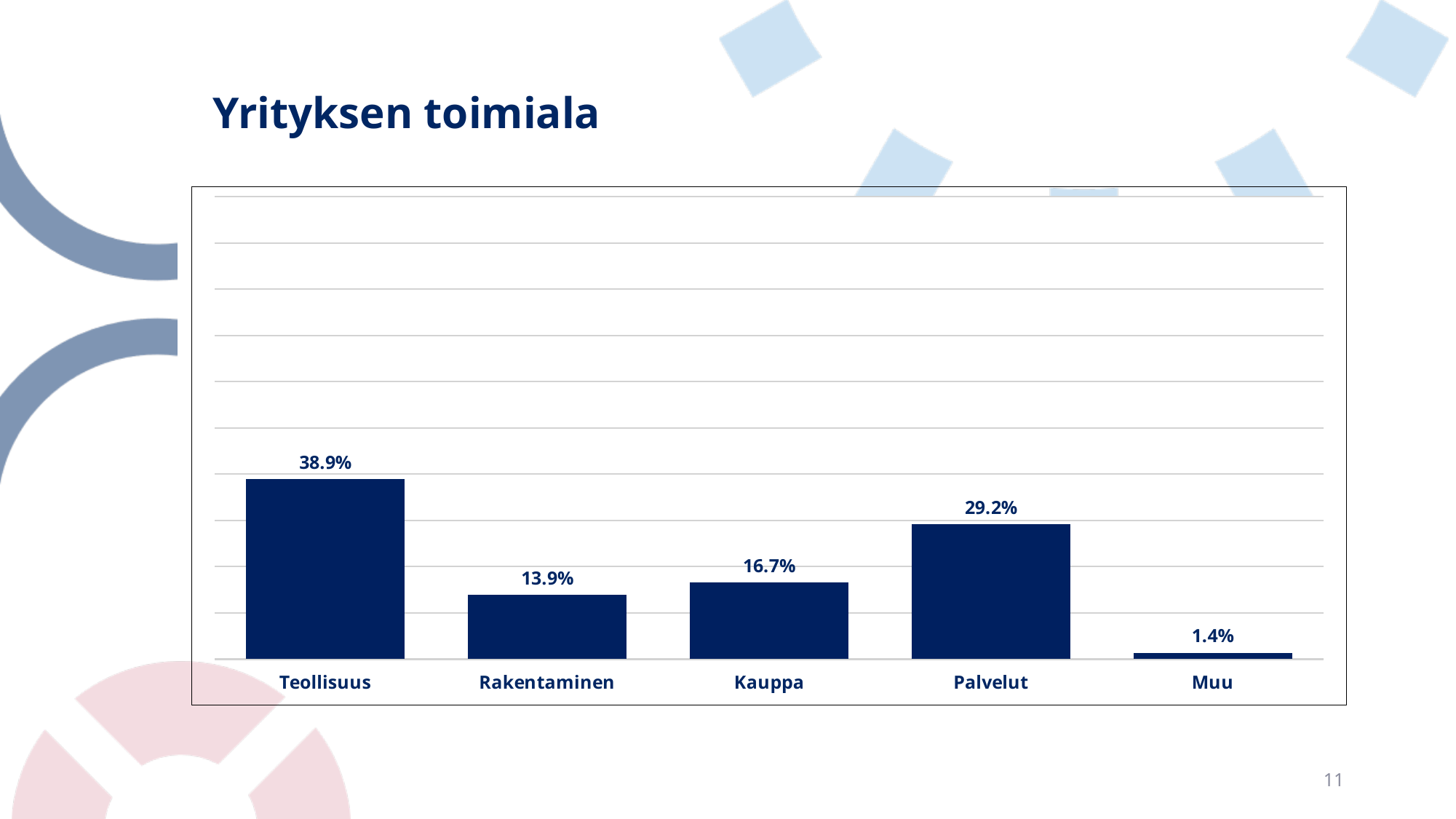
What is the title of the slide? Yrityksen toimiala What is the value for Muu? 1.4% What is the value for Teollisuus? 38.9% Which category has the lowest value? Muu What kind of chart is shown on the slide? Bar chart How many categories are shown in the chart? 5 What is the value for Kauppa? 16.7% What is the value for Palvelut? 29.2% Which category has the highest value? Teollisuus What is the value for Rakentaminen? 13.9% What is the difference between the values for Teollisuus and Palvelut? 9.7% Which is larger, the value for Kauppa or the value for Rakentaminen? Kauppa